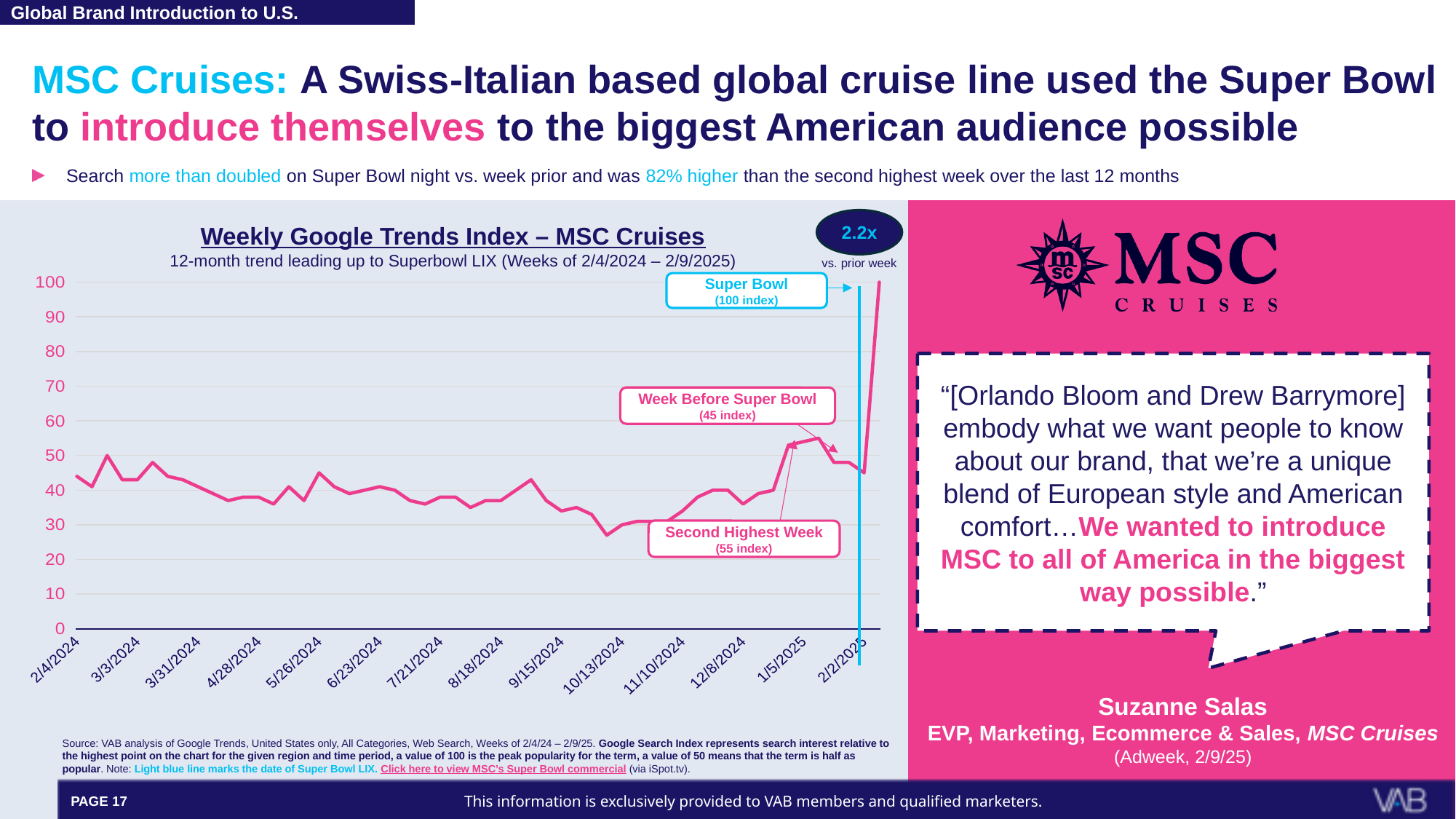
Is the index value for the week of 10/13/2024 greater or less than 40? less What is the difference between the Super Bowl week index and the second highest week index? 45 What is the index value for the second highest week? 55 What kind of chart is shown on the slide? line chart How many date labels are shown on the x axis? 14 What is the title of the chart? Weekly Google Trends Index – MSC Cruises What is the Google Trends index value for the Super Bowl week? 100 How much higher is the Super Bowl week index than the week before the Super Bowl? 55 Which is larger: the index for the week before the Super Bowl or the second highest week? Second highest week What does the light blue vertical line on the chart mark? The date of Super Bowl LIX What is the index value for the week before the Super Bowl? 45 Which week has the highest index value on the chart? Super Bowl week